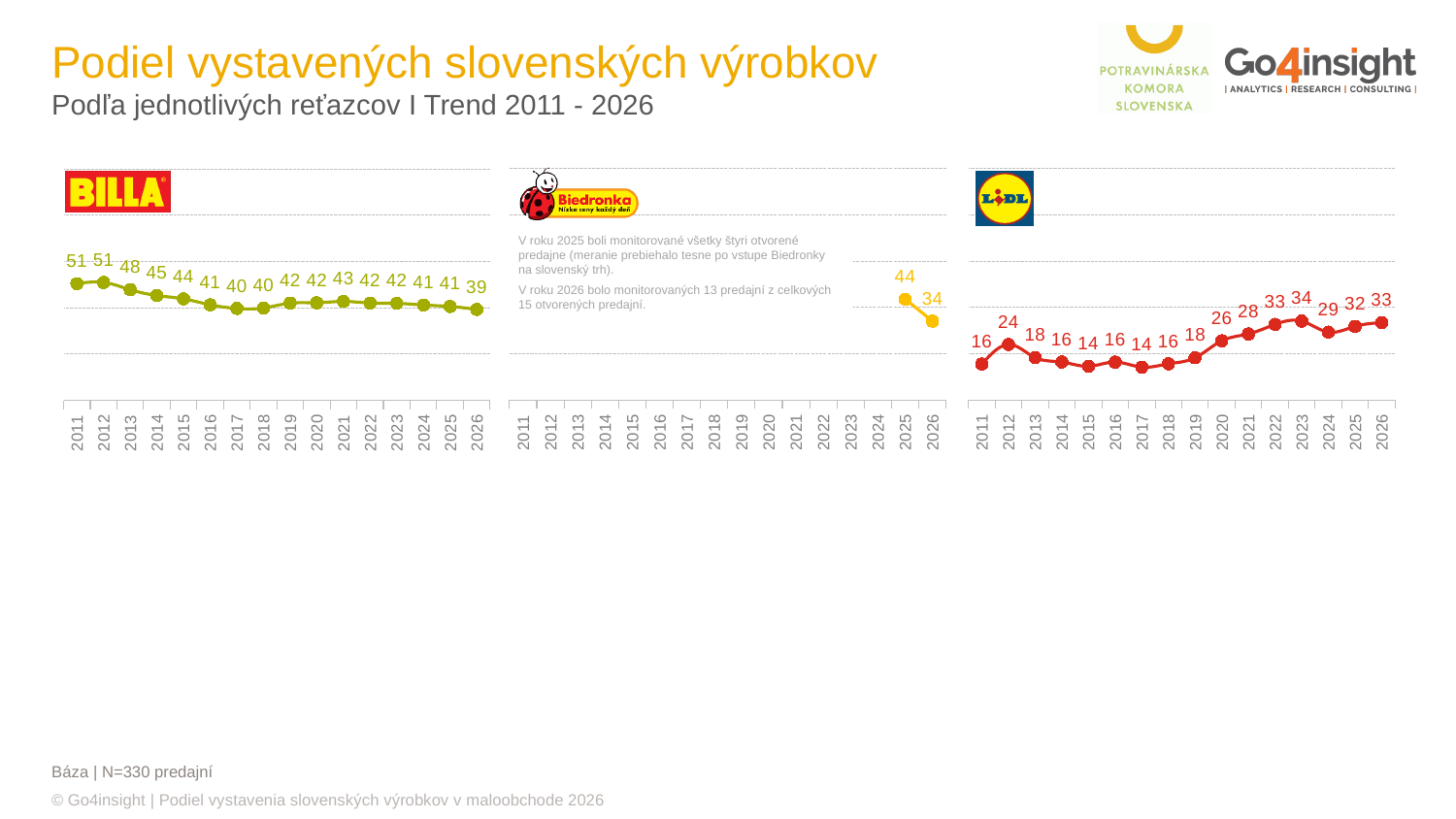
In the Biedronka chart, what is the value for 2025? 44 In the Billa chart, what is the difference between the 2011 value and the 2026 value? 12 In the Billa chart, what is the value for 2011? 51 In the Billa chart, what is the value for 2026? 39 In the Biedronka chart, what is the difference between the 2025 value and the 2026 value? 10 In the Biedronka chart, how many data points are plotted? 2 In the Billa chart, which year has the lowest value? 2026 In the Billa chart, do the values generally rise or fall from 2011 to 2026? fall In the Lidl chart, which year has the highest value? 2023 In the Lidl chart, what is the value for 2023? 34 In the Lidl chart, which is larger, the value for 2012 or the value for 2020? 2020 What kind of chart is used for Lidl? line chart